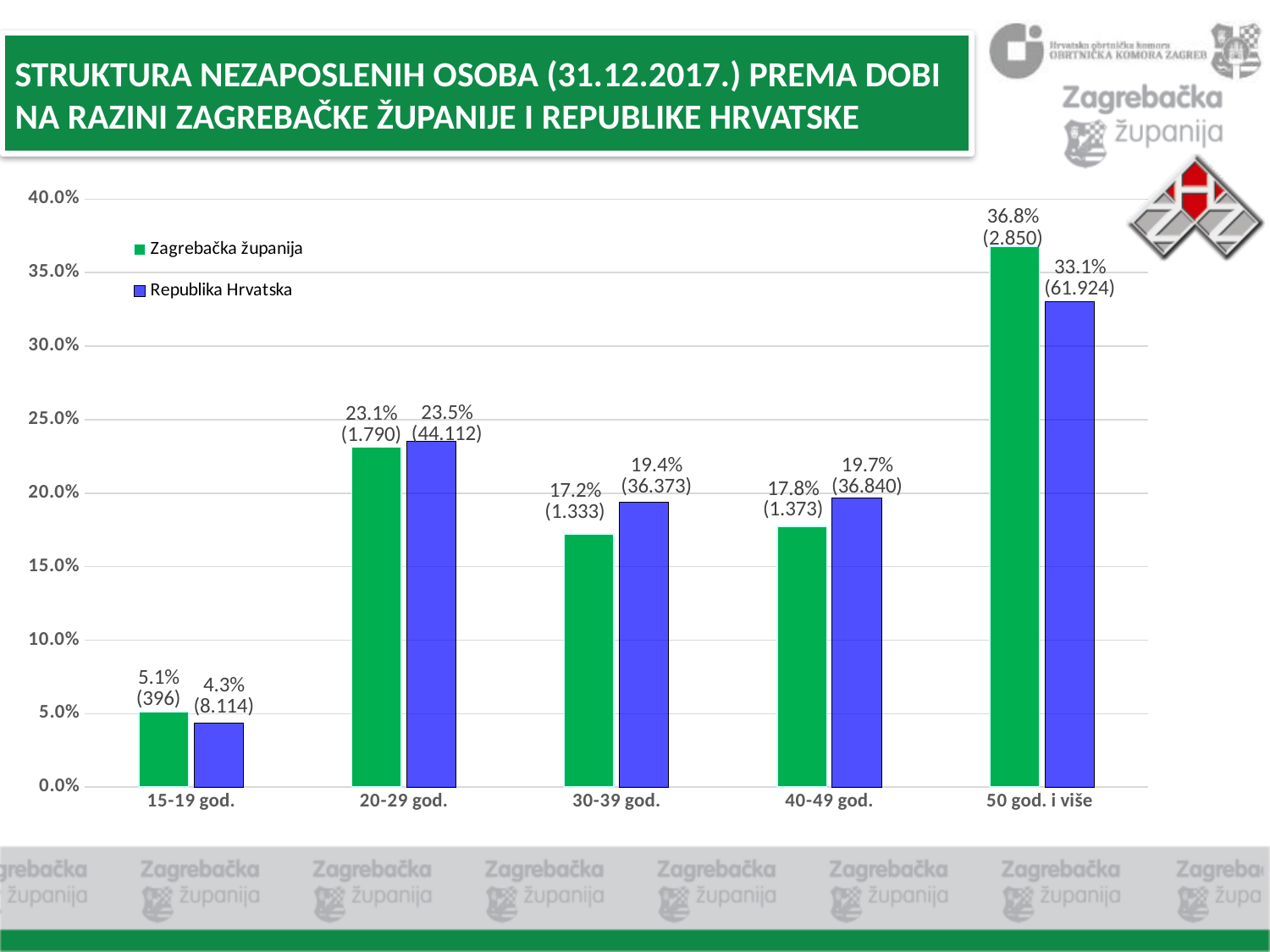
What is the percentage for Republika Hrvatska in the 30-39 god. category? 19.4% What is the percentage for Zagrebačka županija in the 20-29 god. category? 23.1% What is the number in parentheses for Republika Hrvatska in the 50 god. i više category? 61.924 Which age category has the lowest percentage for Republika Hrvatska? 15-19 god. Which colour represents Republika Hrvatska in the chart? blue What is the difference between the Zagrebačka županija and Republika Hrvatska percentages in the 50 god. i više category? 3.7% What type of chart is shown on the slide? bar chart How many age categories are shown on the x axis? 5 In the 40-49 god. category, which series has the larger percentage, Zagrebačka županija or Republika Hrvatska? Republika Hrvatska Is the value for Zagrebačka županija in the 15-19 god. category greater or less than 10.0%? less How many series does the legend list? 2 Which age category has the highest percentage for Zagrebačka županija? 50 god. i više